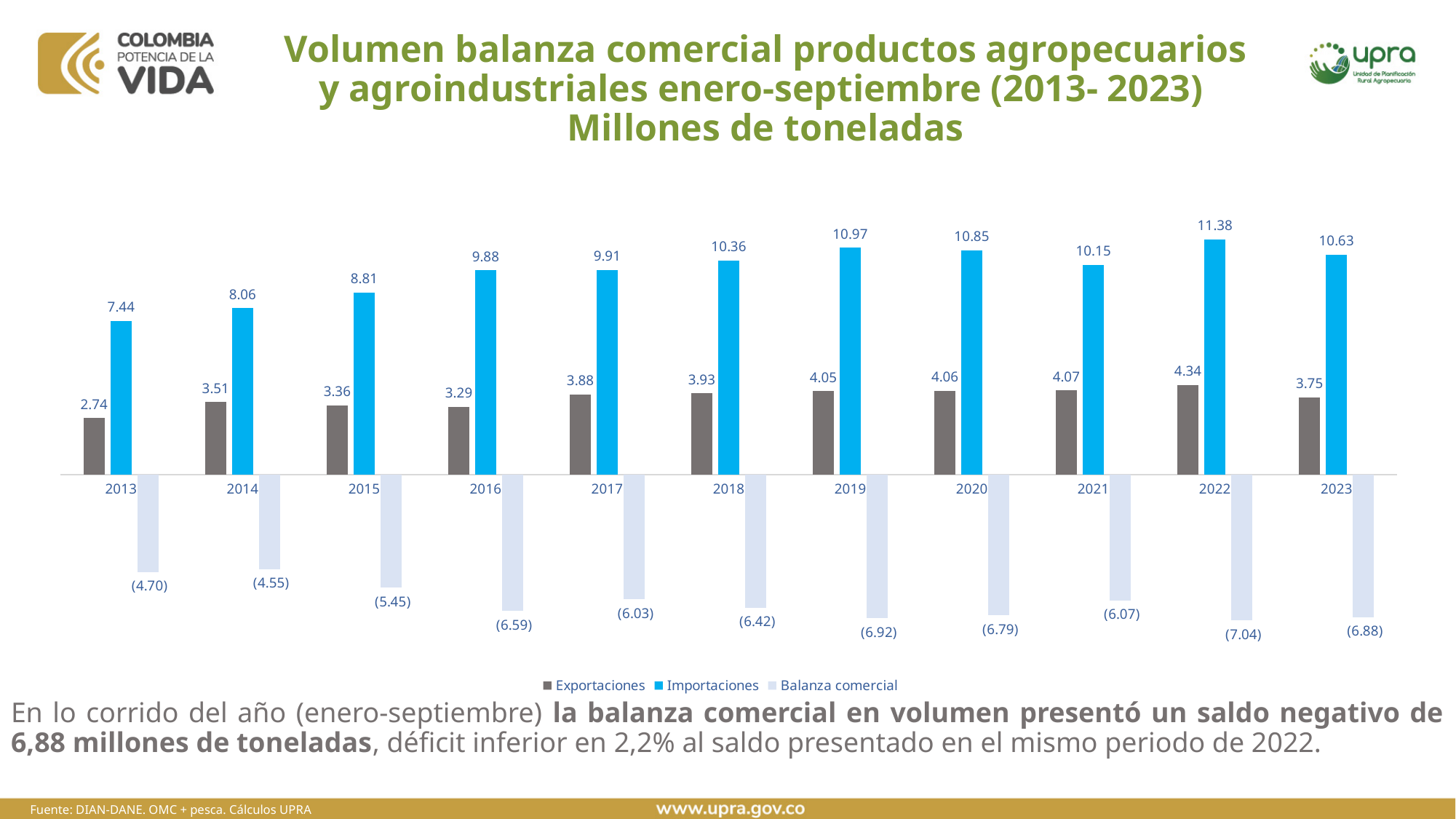
What kind of chart is shown on the slide? Bar chart What is the value of Importaciones for 2023? 10.63 What is the value of Exportaciones for 2013? 2.74 How many years are shown on the x axis? 11 What is the value of Balanza comercial for 2022? (7.04) Which year has the highest Importaciones value? 2022 How many series does the legend list? 3 Which year has the lowest Exportaciones value? 2013 What is the difference between Importaciones and Exportaciones in 2019? 6.92 Do the Importaciones values rise or fall from 2013 to 2019? Rise Which series is shown in light blue in the legend? Balanza comercial Which is larger, Exportaciones in 2022 or Exportaciones in 2023? Exportaciones in 2022